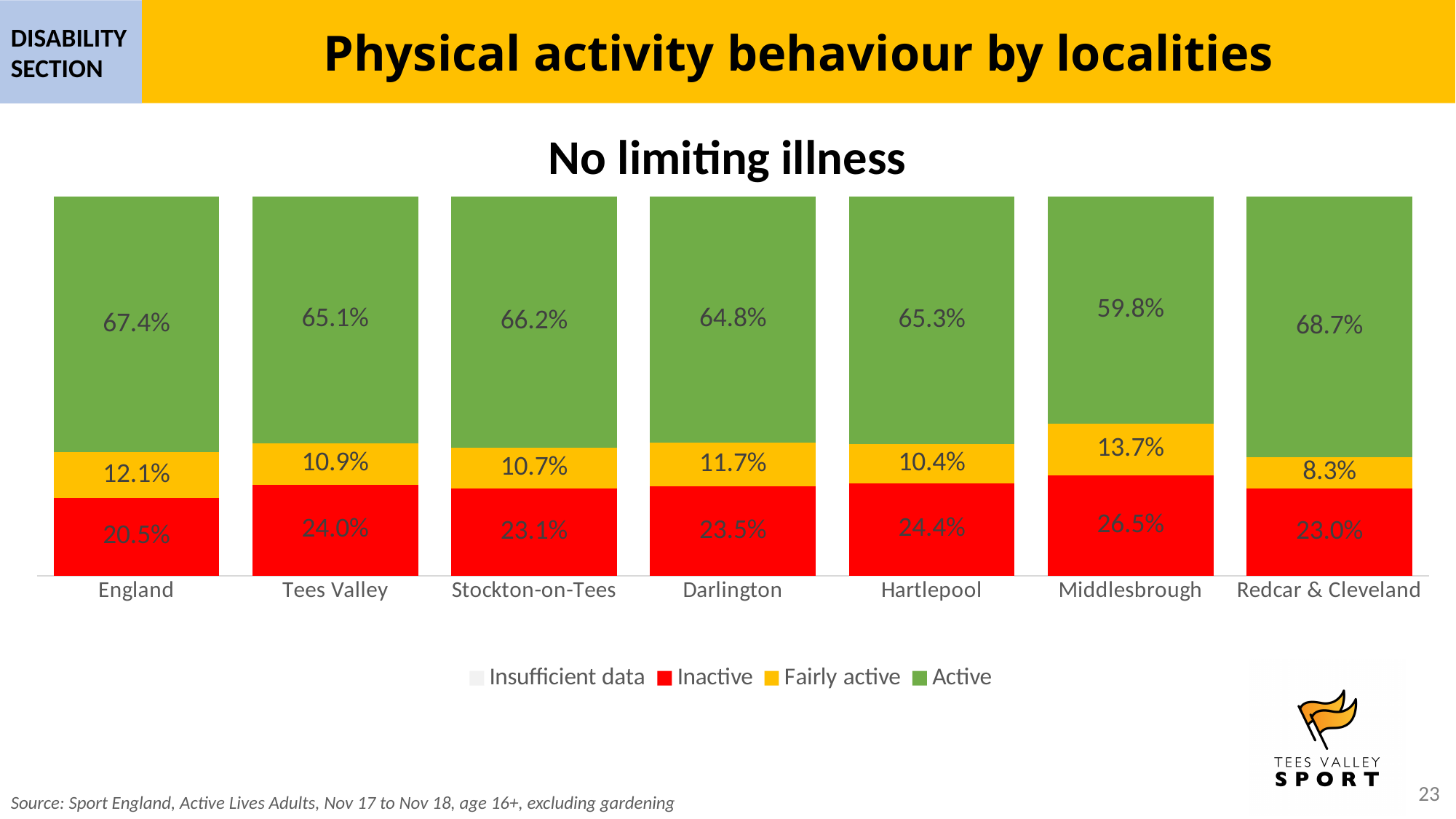
Which locality has the lowest Active percentage? Middlesbrough What is the Active percentage for England? 67.4% Which locality has the lowest Fairly active percentage? Redcar & Cleveland Which has a higher Inactive percentage, Tees Valley or England? Tees Valley What is the difference in Active percentage between Redcar & Cleveland and Middlesbrough? 8.9 percentage points What is the total of the stacked bar for Middlesbrough? 100.0% What is the Fairly active percentage for Darlington? 11.7% What kind of chart is shown? Stacked bar chart What is the Inactive percentage for Middlesbrough? 26.5% How many localities are shown on the x axis? 7 How many series does the legend list? 4 Which locality has the highest Active percentage? Redcar & Cleveland